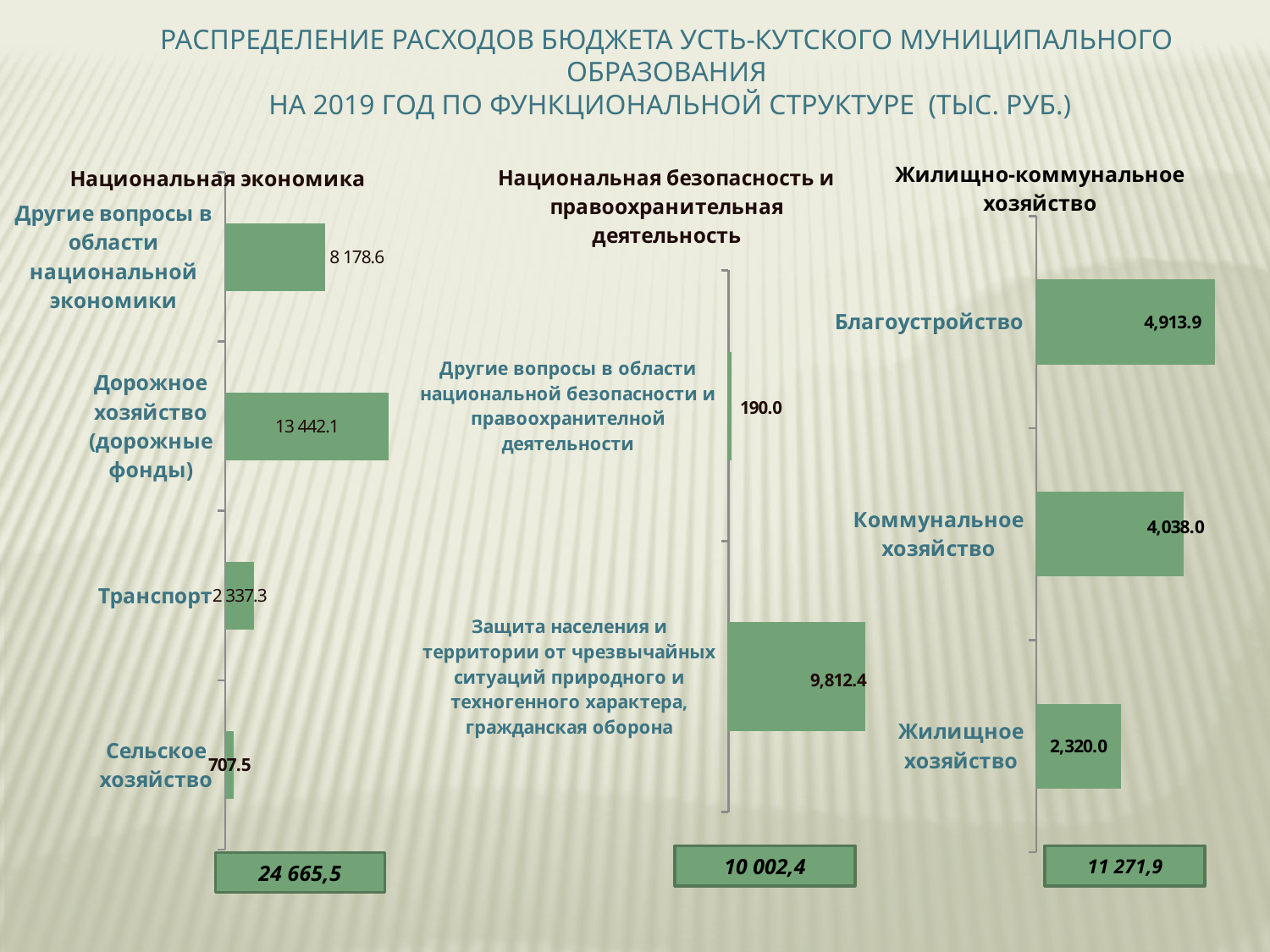
What total is shown in the box below the 'Национальная экономика' chart? 24 665,5 In the 'Национальная экономика' chart, which category has the lowest value? Сельское хозяйство What type of chart is the 'Жилищно-коммунальное хозяйство' chart? Bar chart In the 'Жилищно-коммунальное хозяйство' chart, which is larger: Благоустройство or Жилищное хозяйство? Благоустройство In the 'Национальная безопасность и правоохранительная деятельность' chart, what is the value for Другие вопросы в области национальной безопасности и правоохранителной деятельности? 190.0 In the 'Национальная безопасность и правоохранительная деятельность' chart, what is the value for Защита населения и территории от чрезвычайных ситуаций природного и техногенного характера, гражданская оборона? 9,812.4 In the 'Национальная экономика' chart, how many categories are plotted? 4 In the 'Жилищно-коммунальное хозяйство' chart, what is the difference between Благоустройство and Коммунальное хозяйство? 875.9 In the 'Национальная экономика' chart, which category has the highest value? Дорожное хозяйство (дорожные фонды) In the 'Национальная экономика' chart, what is the value for Дорожное хозяйство (дорожные фонды)? 13 442.1 In the 'Жилищно-коммунальное хозяйство' chart, what is the value for Коммунальное хозяйство? 4,038.0 In the 'Национальная экономика' chart, what is the difference between Дорожное хозяйство (дорожные фонды) and Другие вопросы в области национальной экономики? 5 263.5